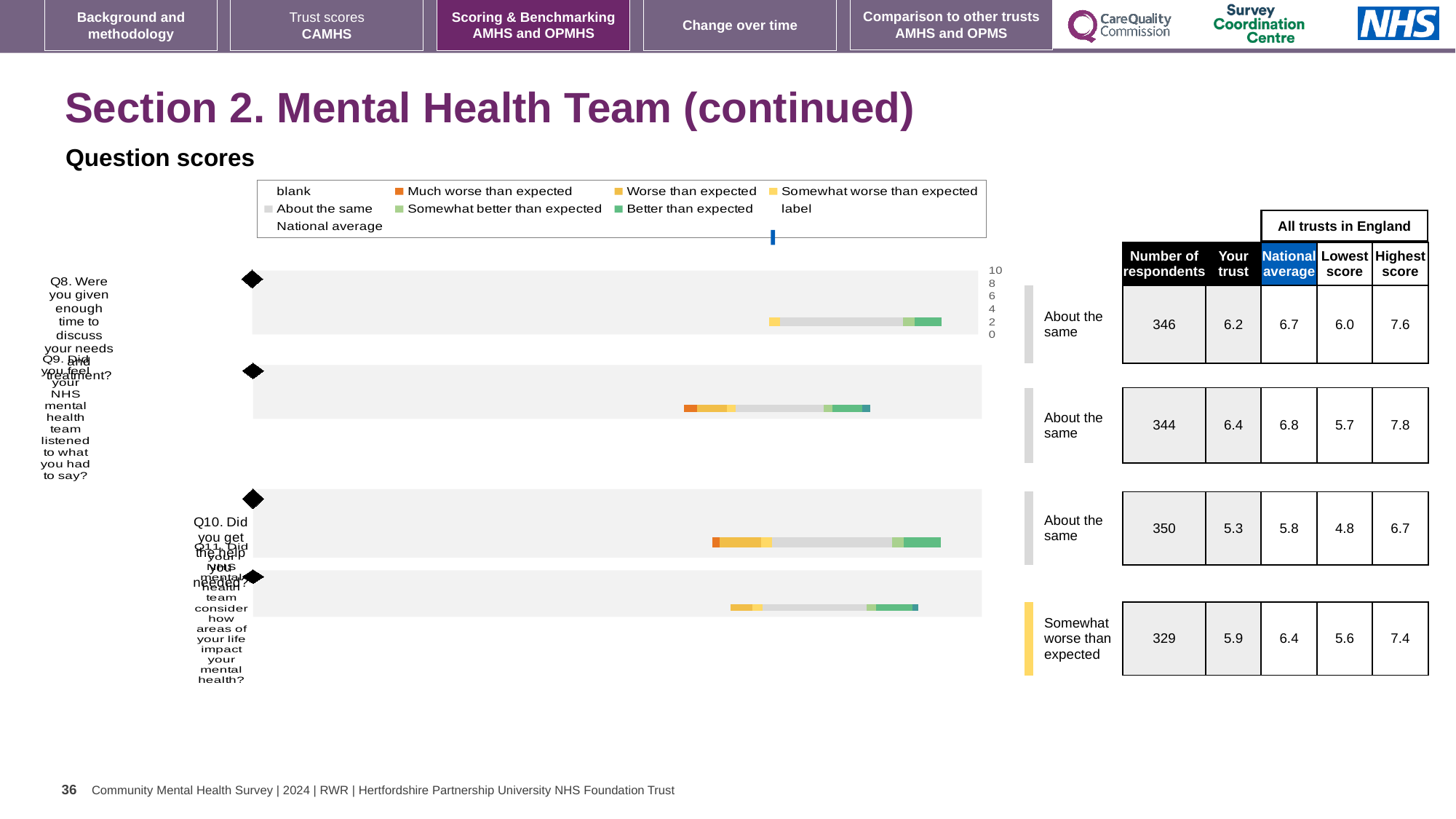
In the table beside the chart, what is the 'Your trust' score for Q9? 6.4 Which question has the highest 'Your trust' score in the table beside the chart? Q9 In the table beside the chart, what is the national average for Q10? 5.8 In the table beside the chart, what is the highest score across all trusts in England for Q11? 7.4 In the chart legend, what colour represents 'Much worse than expected'? orange Which question has the lowest 'Your trust' score in the table beside the chart? Q10 In the table beside the chart, how many respondents are listed for Q8? 346 For Q8, what is the difference between the national average and the 'Your trust' score shown in the table? 0.5 What is the highest tick value shown on the chart's score axis? 10 For Q11, which is larger: the 'Your trust' score or the national average? National average What kind of chart is used to show the question scores on this slide? bar chart How many questions (Q8 to Q11) have bars plotted in the question scores chart? 4